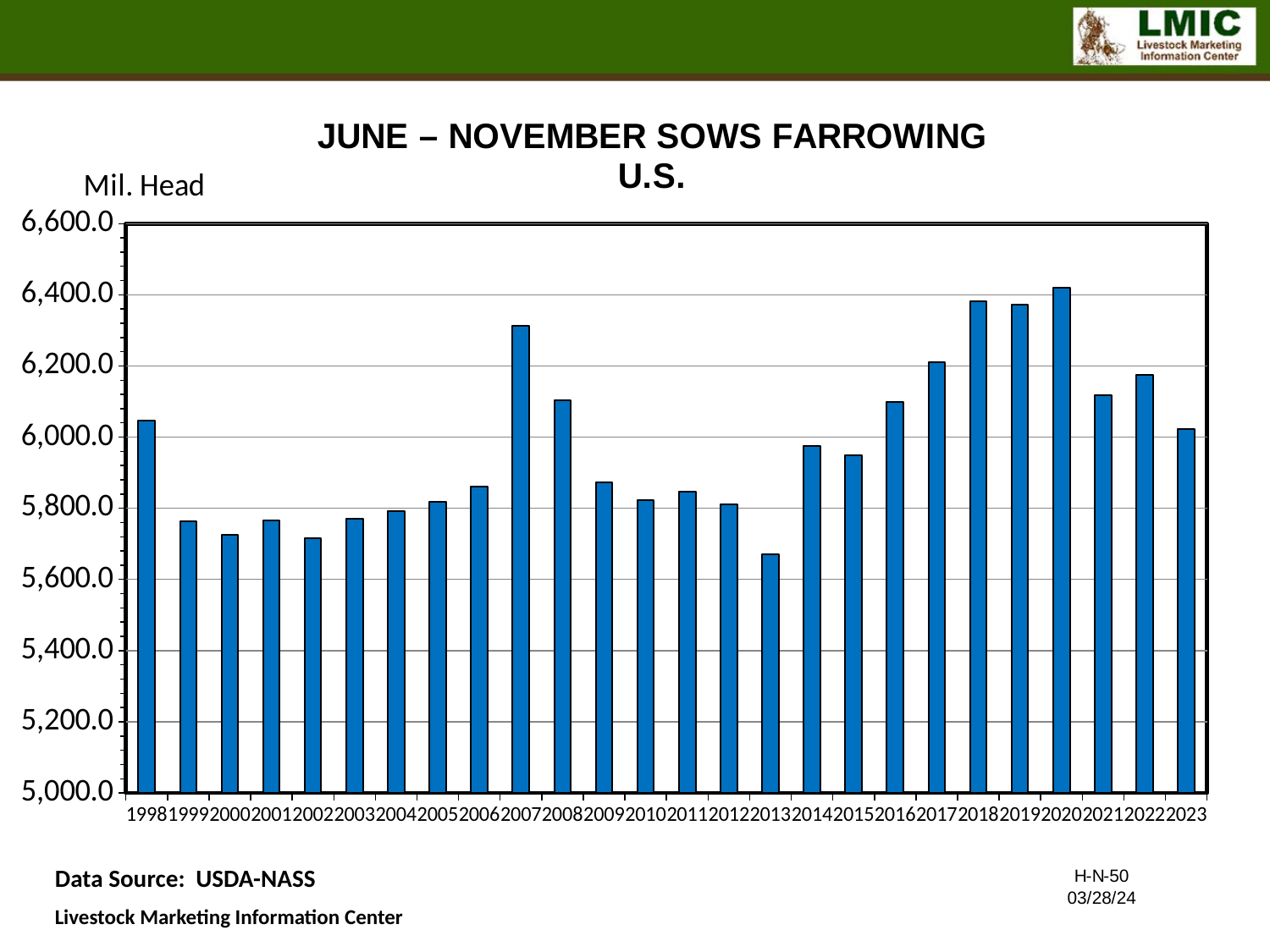
Is the value for 2018 greater or less than 6,200.0? greater How many years are plotted on the chart? 26 Is the value for 2013 greater or less than 5,800.0? less What kind of chart is shown on the slide? bar chart Is the value for 2007 greater or less than 6,200.0? greater Which year has the larger value, 2013 or 2014? 2014 Do the values generally rise or fall from 2013 to 2020? rise What unit is shown on the vertical axis label? Mil. Head Which year has the highest value for June–November sows farrowing? 2020 Which year has the larger value, 2007 or 2008? 2007 Which year has the lowest value for June–November sows farrowing? 2013